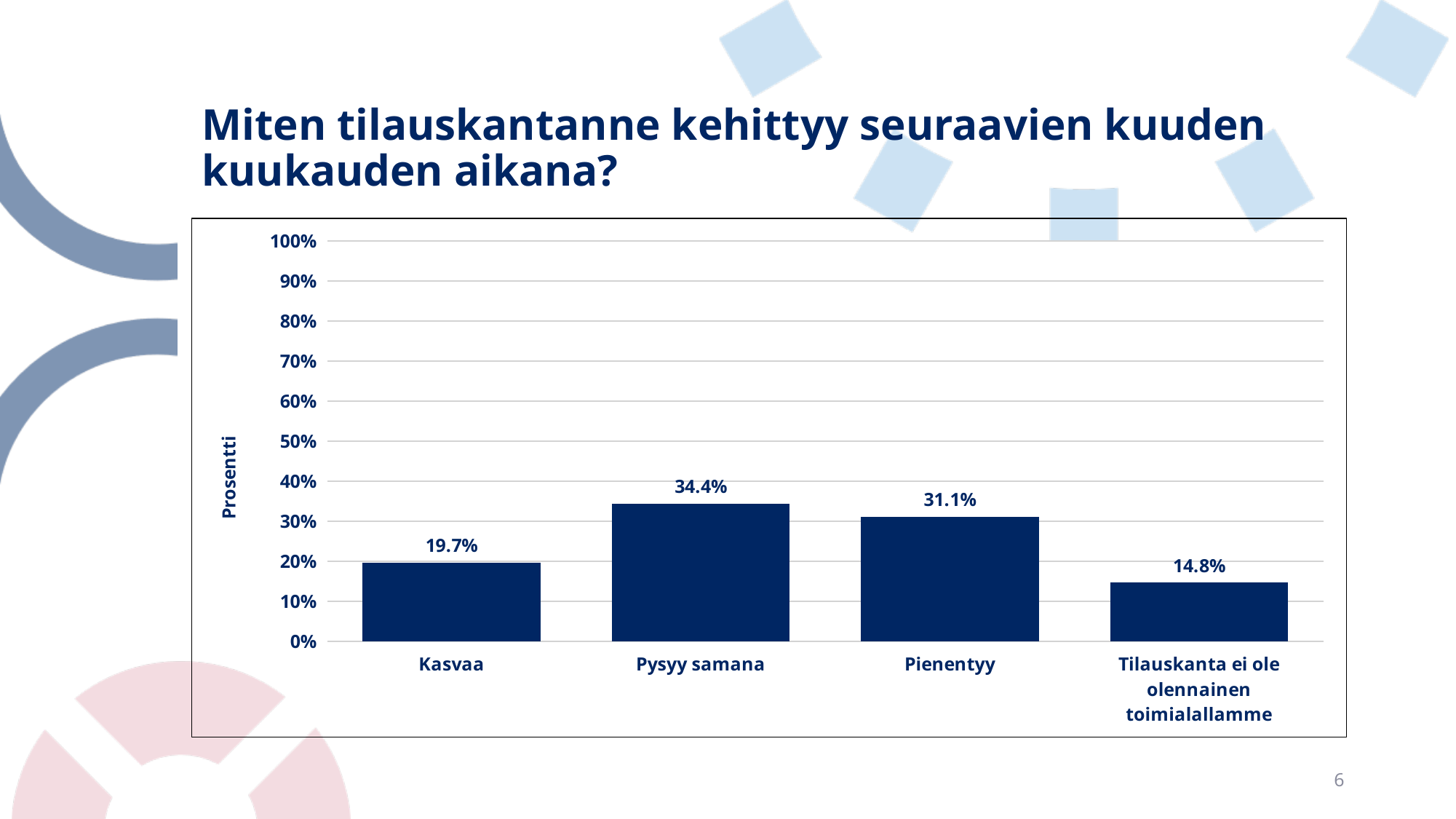
What is the difference between the values for Kasvaa and Tilauskanta ei ole olennainen toimialallamme? 4.9% What is the label of the vertical axis? Prosentti What is the value for Tilauskanta ei ole olennainen toimialallamme? 14.8% How many categories are shown in the chart? 4 What kind of chart is shown on the slide? Bar chart What is the difference between the values for Pysyy samana and Pienentyy? 3.3% Which category has the lowest value? Tilauskanta ei ole olennainen toimialallamme What is the value for Pysyy samana? 34.4% What is the value for Kasvaa? 19.7% Which category has the highest value? Pysyy samana What is the value for Pienentyy? 31.1% Which is larger, the value for Kasvaa or the value for Pienentyy? Pienentyy